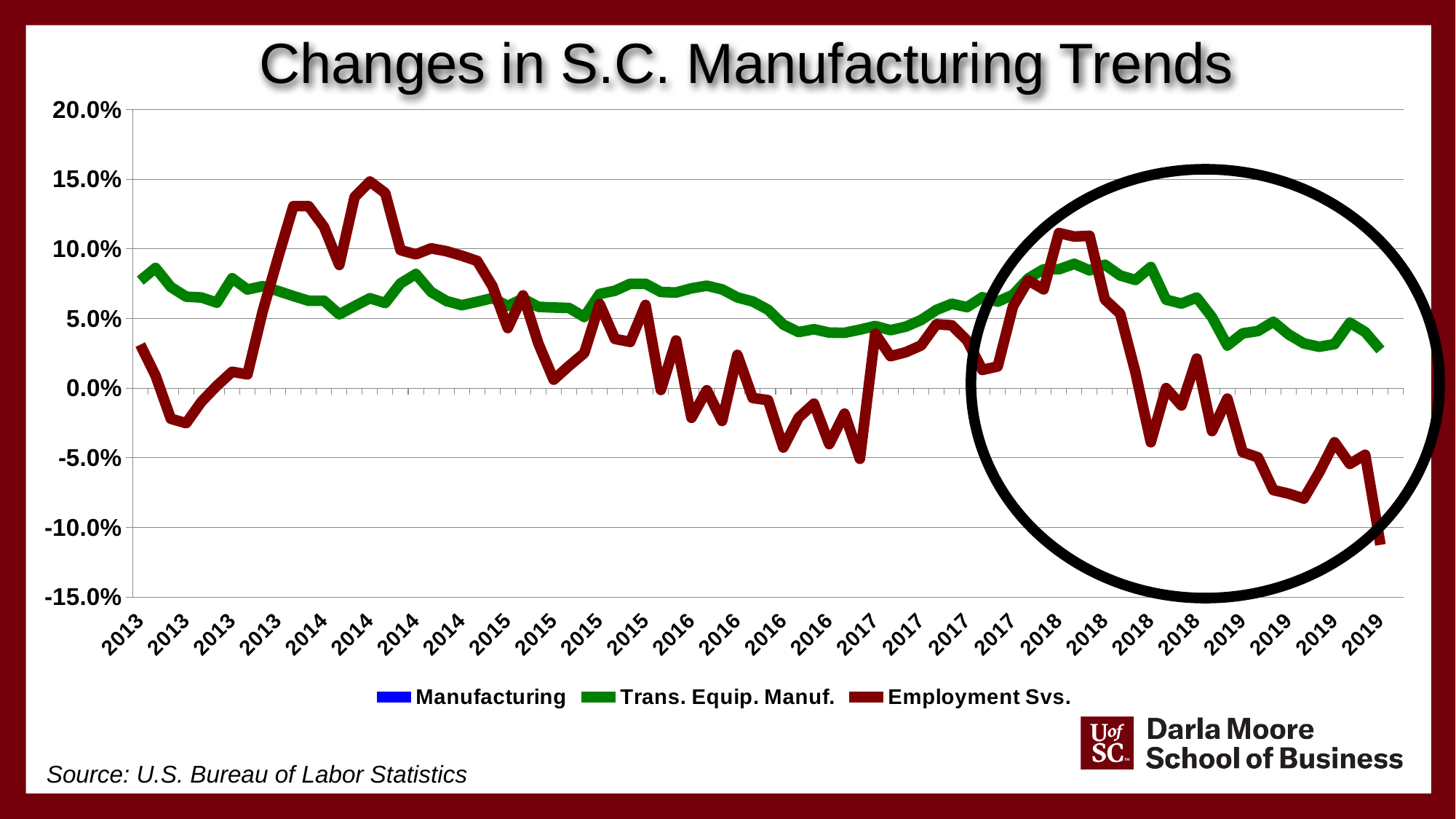
How many series does the legend list? 3 Which series reaches the highest value anywhere on the chart? Employment Svs. Is the peak value for Employment Svs. in 2014 greater or less than 10.0%? greater What kind of chart is shown on the slide? Line chart At the last 2019 point, which series is higher: Trans. Equip. Manuf. or Employment Svs.? Trans. Equip. Manuf. Does the Employment Svs. line rise or fall from the start of 2018 to the end of 2019? Fall What is the title of the chart? Changes in S.C. Manufacturing Trends Is the value for Trans. Equip. Manuf. at the last 2019 point greater or less than 5.0%? less Which series reaches the lowest value anywhere on the chart? Employment Svs. Is the value for Employment Svs. at the last 2019 point greater or less than -5.0%? less What source is cited for the chart data? U.S. Bureau of Labor Statistics